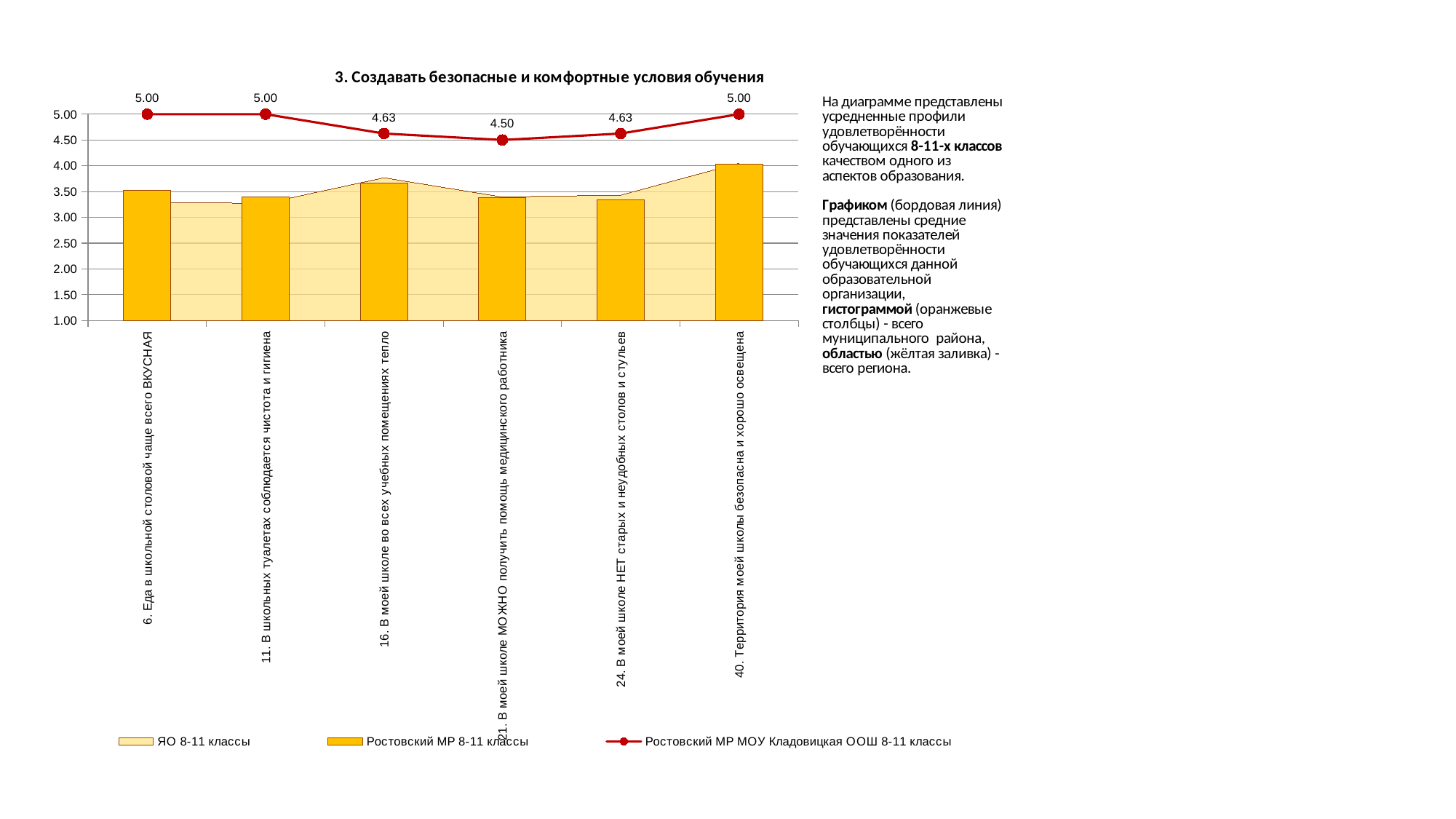
What is the title of the chart? 3. Создавать безопасные и комфортные условия обучения What is the value of the Ростовский МР МОУ Кладовицкая ООШ 8-11 классы line for category 40 (Территория моей школы безопасна и хорошо освещена)? 5.00 For which category is the Ростовский МР МОУ Кладовицкая ООШ 8-11 классы line lowest? 21. В моей школе МОЖНО получить помощь медицинского работника For which category is the Ростовский МР 8-11 классы bar the highest? 40. Территория моей школы безопасна и хорошо освещена Which Ростовский МР 8-11 классы bar is taller: category 40 (Территория моей школы безопасна и хорошо освещена) or category 11 (В школьных туалетах соблюдается чистота и гигиена)? 40. Территория моей школы безопасна и хорошо освещена How many series does the legend list? 3 What is the value of the Ростовский МР МОУ Кладовицкая ООШ 8-11 классы line for category 21 (В моей школе МОЖНО получить помощь медицинского работника)? 4.50 What is the difference between the line values for category 6 (Еда в школьной столовой чаще всего ВКУСНАЯ) and category 21 (В моей школе МОЖНО получить помощь медицинского работника)? 0.50 What is the value of the Ростовский МР МОУ Кладовицкая ООШ 8-11 классы line for category 16 (В моей школе во всех учебных помещениях тепло)? 4.63 Is the Ростовский МР 8-11 классы bar for category 40 (Территория моей школы безопасна и хорошо освещена) greater or less than 3.50? greater Is the Ростовский МР 8-11 классы bar for category 11 (В школьных туалетах соблюдается чистота и гигиена) greater or less than 3.50? less How many categories are shown on the x axis of the chart? 6